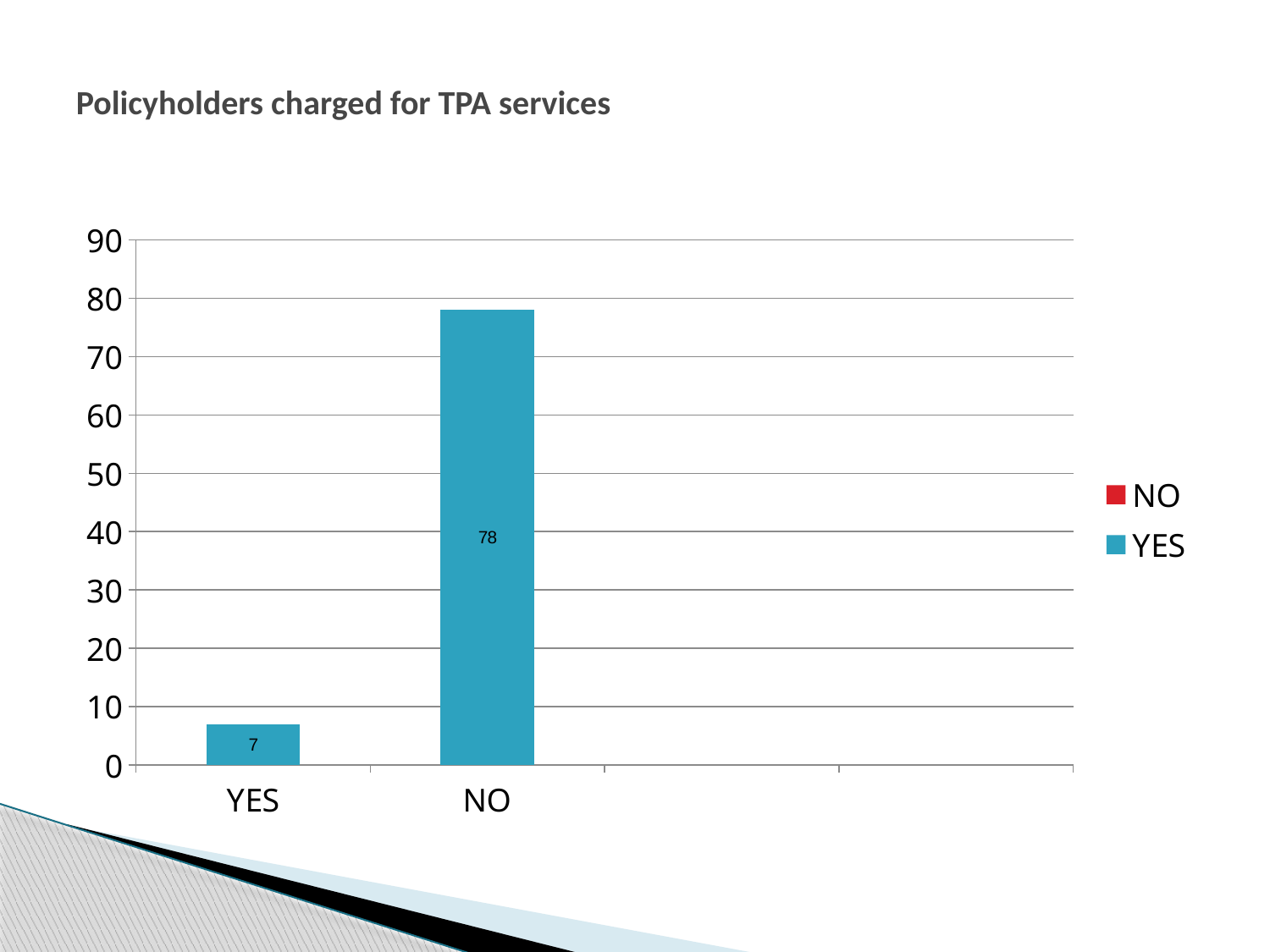
Which category has the highest value? NO What kind of chart is shown? bar chart Is the value for NO greater or less than 70? greater How many categories are shown on the x axis? 2 Which category has the lowest value? YES Which is larger, the value for YES or the value for NO? NO What is the value for YES? 7 What is the value for NO? 78 How many entries does the legend list? 2 What is the title of the slide? Policyholders charged for TPA services What is the difference between the values for NO and YES? 71 Is the value for YES greater or less than 10? less